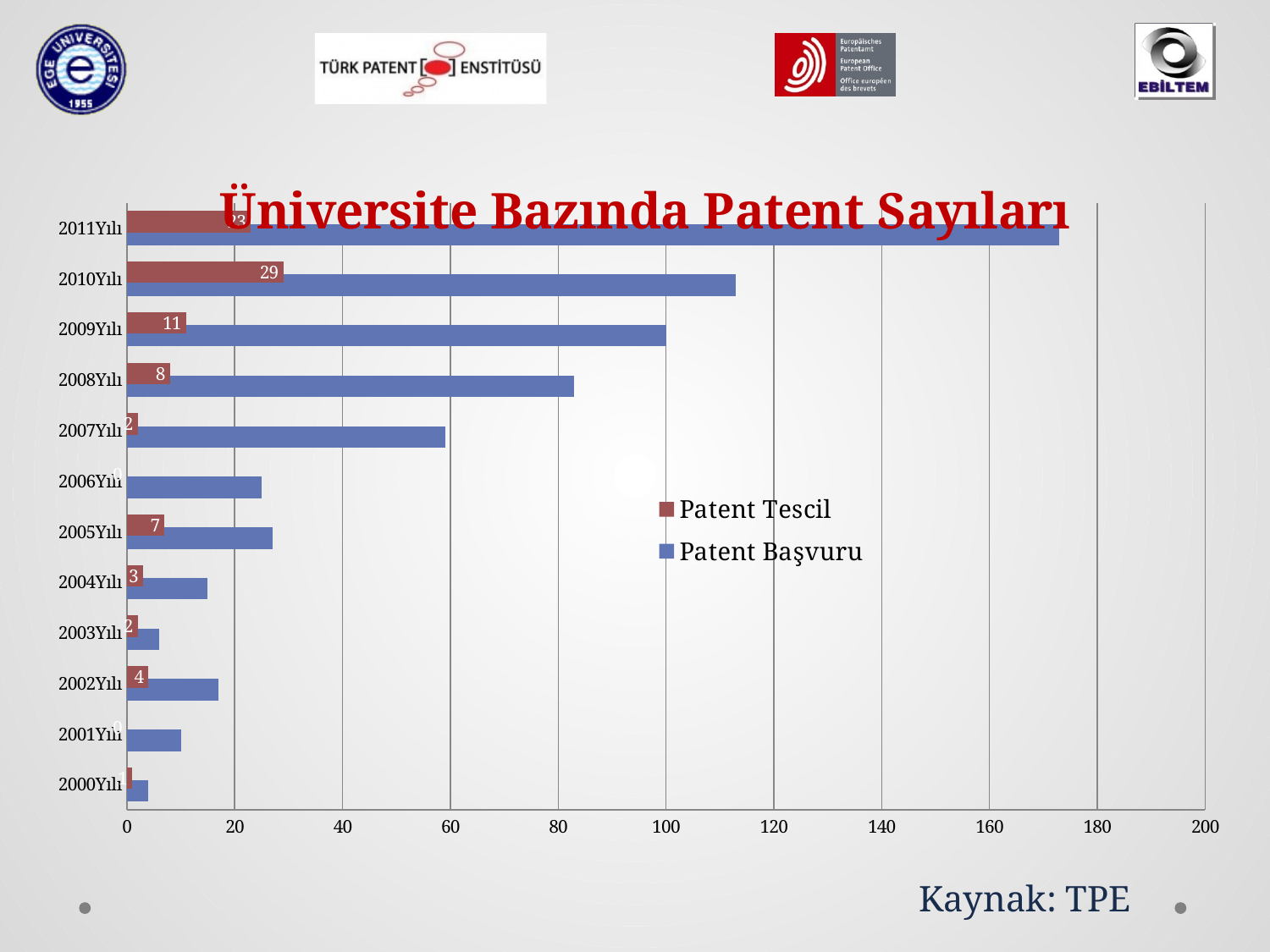
What is the title of the chart? Üniversite Bazında Patent Sayıları Which year has the longest Patent Başvuru bar? 2011Yılı What is the Patent Tescil value for 2010Yılı? 29 Which year has the highest Patent Tescil value? 2010Yılı How many year categories are shown on the chart? 12 What is the difference between the Patent Tescil values for 2010Yılı and 2009Yılı? 18 What is the Patent Tescil value for 2009Yılı? 11 What is the Patent Tescil value for 2005Yılı? 7 How many series does the legend list? 2 What type of chart is shown on the slide? bar chart Is the Patent Başvuru value for 2011Yılı greater or less than 160? greater